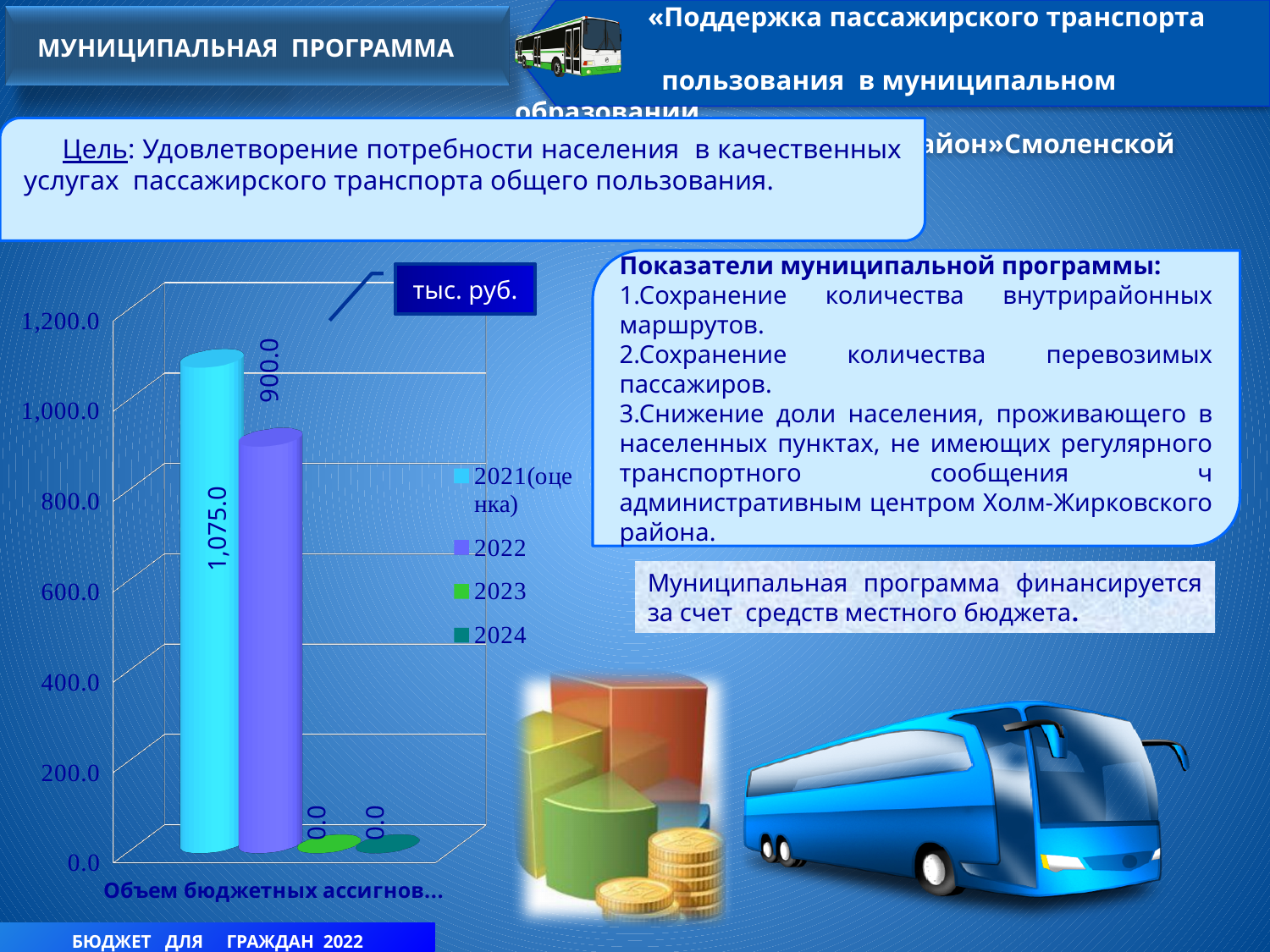
What is the value for the 2024 series in the chart? 0.0 What unit of measurement is shown in the box above the chart? тыс. руб. Which series has the highest value in the chart? 2021(оценка) What is the value for the 2022 series in the chart? 900.0 Is the value for 2022 greater or less than 1,000.0? less What is the value for the 2021(оценка) series in the chart? 1,075.0 How many series does the chart legend list? 4 Is the value for 2021(оценка) greater or less than 1,000.0? greater Which is larger, the value for 2021(оценка) or the value for 2022? 2021(оценка) What is the value for the 2023 series in the chart? 0.0 What is the difference between the 2021(оценка) value and the 2022 value? 175.0 What kind of chart is shown on the slide? bar chart